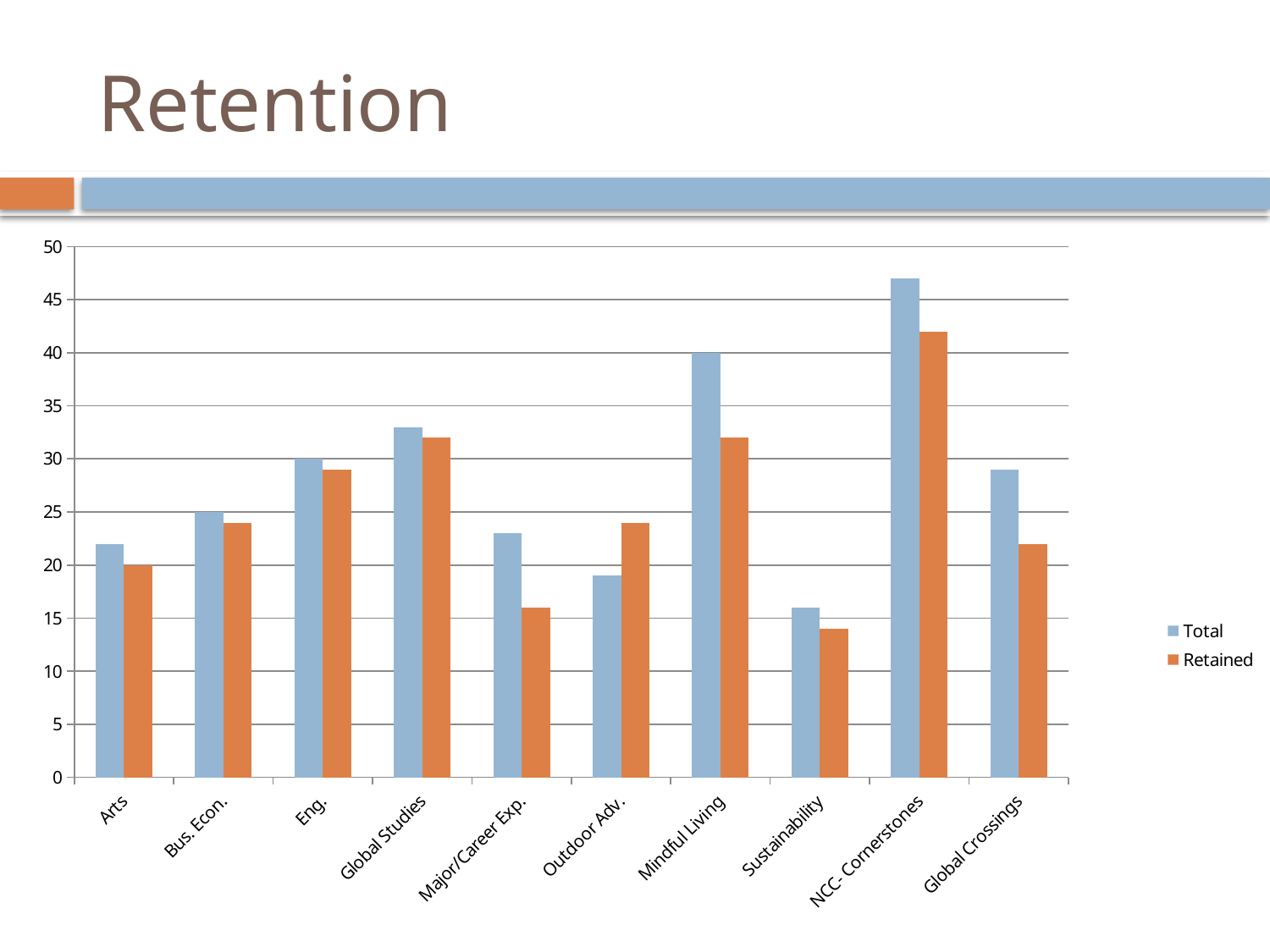
For Outdoor Adv., which is larger, the Total value or the Retained value? Retained Is the Retained value for Global Studies greater or less than 30? greater What is the Total value for Eng.? 30 How many series does the legend list? 2 What kind of chart is shown on the slide? bar chart Which category has the highest Total value? NCC- Cornerstones What are the two series named in the legend? Total and Retained How many categories are shown on the x axis? 10 Which category has the lowest Retained value? Sustainability Is the Total value for NCC- Cornerstones greater or less than 45? greater What is the Total value for Mindful Living? 40 Is the Retained value for Sustainability greater or less than 15? less